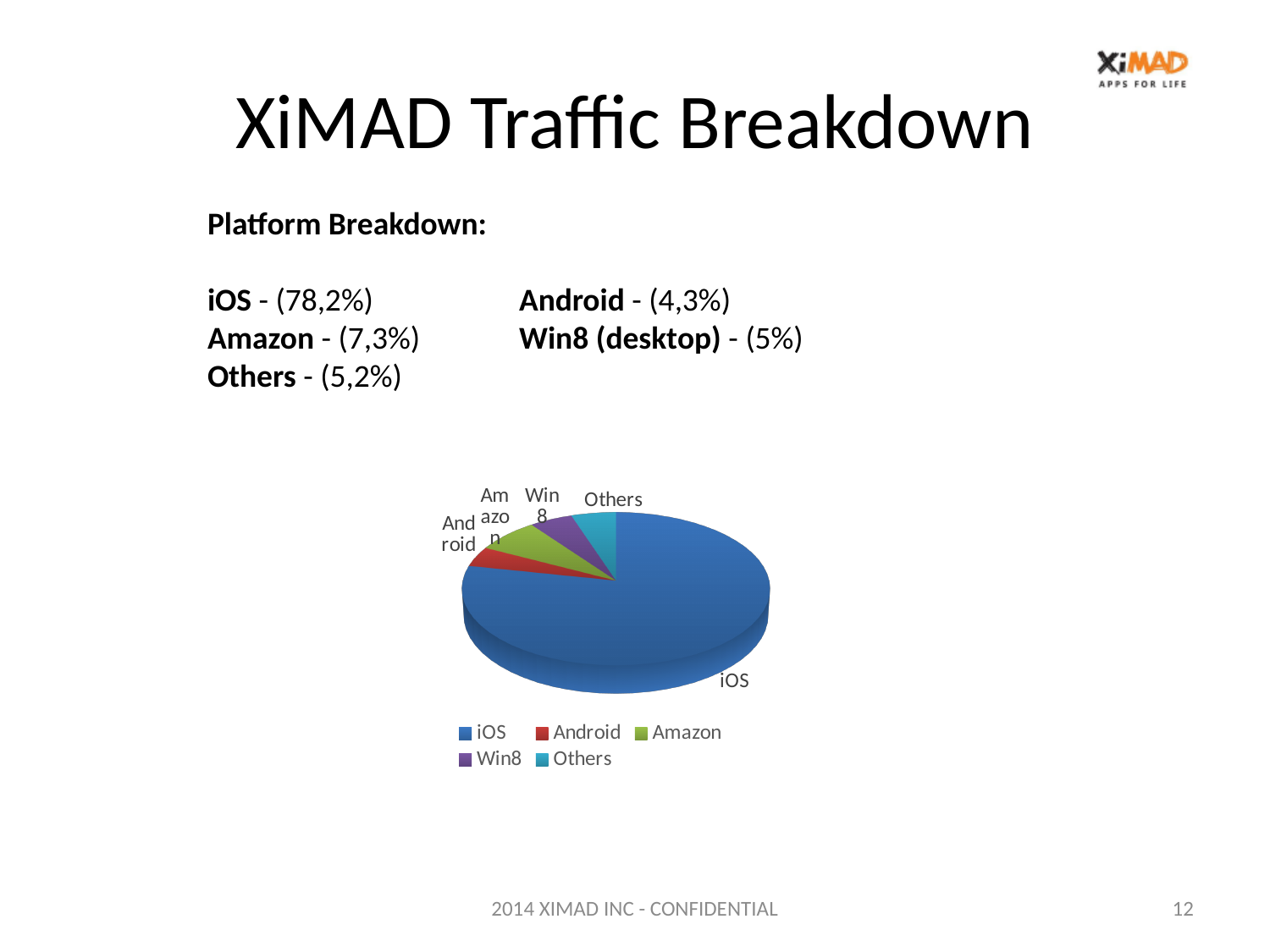
Which platform has the smallest share of traffic according to the slide? Android What share of traffic does Amazon account for? 7,3% What colour is the iOS slice in the pie chart? blue Which slice is larger, Amazon or Android? Amazon What is the difference in percentage points between the Amazon share and the Android share? 3% What share of traffic does iOS account for? 78,2% What share of traffic does Win8 (desktop) account for? 5% What is the difference in percentage points between the iOS share and the Amazon share? 70,9% How many slices does the pie chart have? 5 What kind of chart is shown on the slide? pie chart How many entries does the legend of the pie chart list? 5 Which platform has the largest slice of the pie chart? iOS